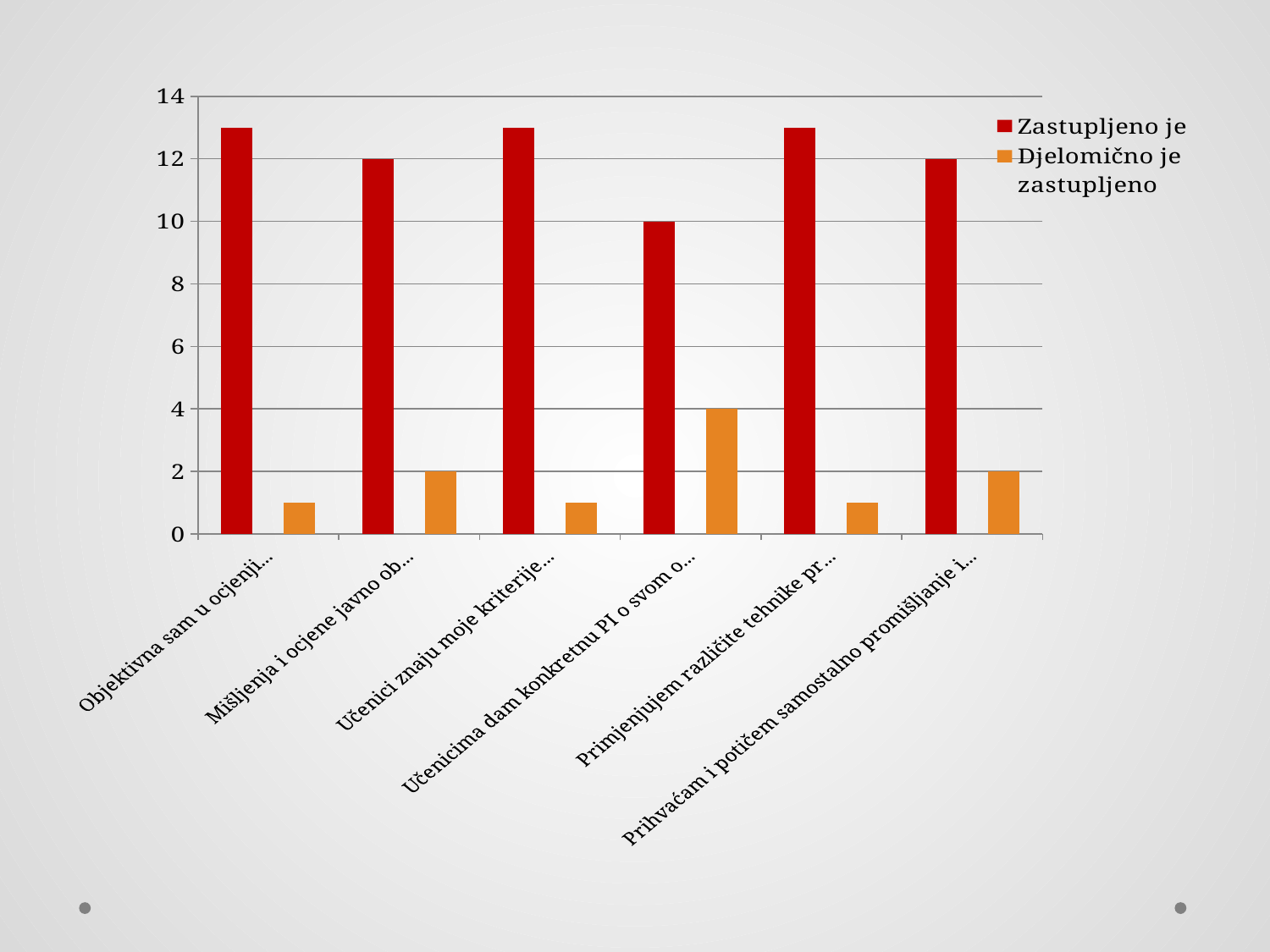
What is the value of "Djelomično je zastupljeno" for the category "Učenicima dam konkretnu PI o svom o..."? 4 Which category has the lowest value for "Zastupljeno je"? Učenicima dam konkretnu PI o svom o... What is the value of "Zastupljeno je" for the category "Učenicima dam konkretnu PI o svom o..."? 10 How many categories are shown on the x axis? 6 How many series does the legend list? 2 What is the value of "Zastupljeno je" for the category "Mišljenja i ocjene javno ob..."? 12 What is the difference between "Zastupljeno je" and "Djelomično je zastupljeno" for the category "Učenicima dam konkretnu PI o svom o..."? 6 What kind of chart is shown on the slide? bar chart Which series is shown in orange in the legend? Djelomično je zastupljeno What is the value of "Djelomično je zastupljeno" for the category "Prihvaćam i potičem samostalno promišljanje i..."? 2 Which category has the highest value for "Djelomično je zastupljeno"? Učenicima dam konkretnu PI o svom o... Is the value of "Zastupljeno je" for "Objektivna sam u ocjenji..." greater or less than 12? greater